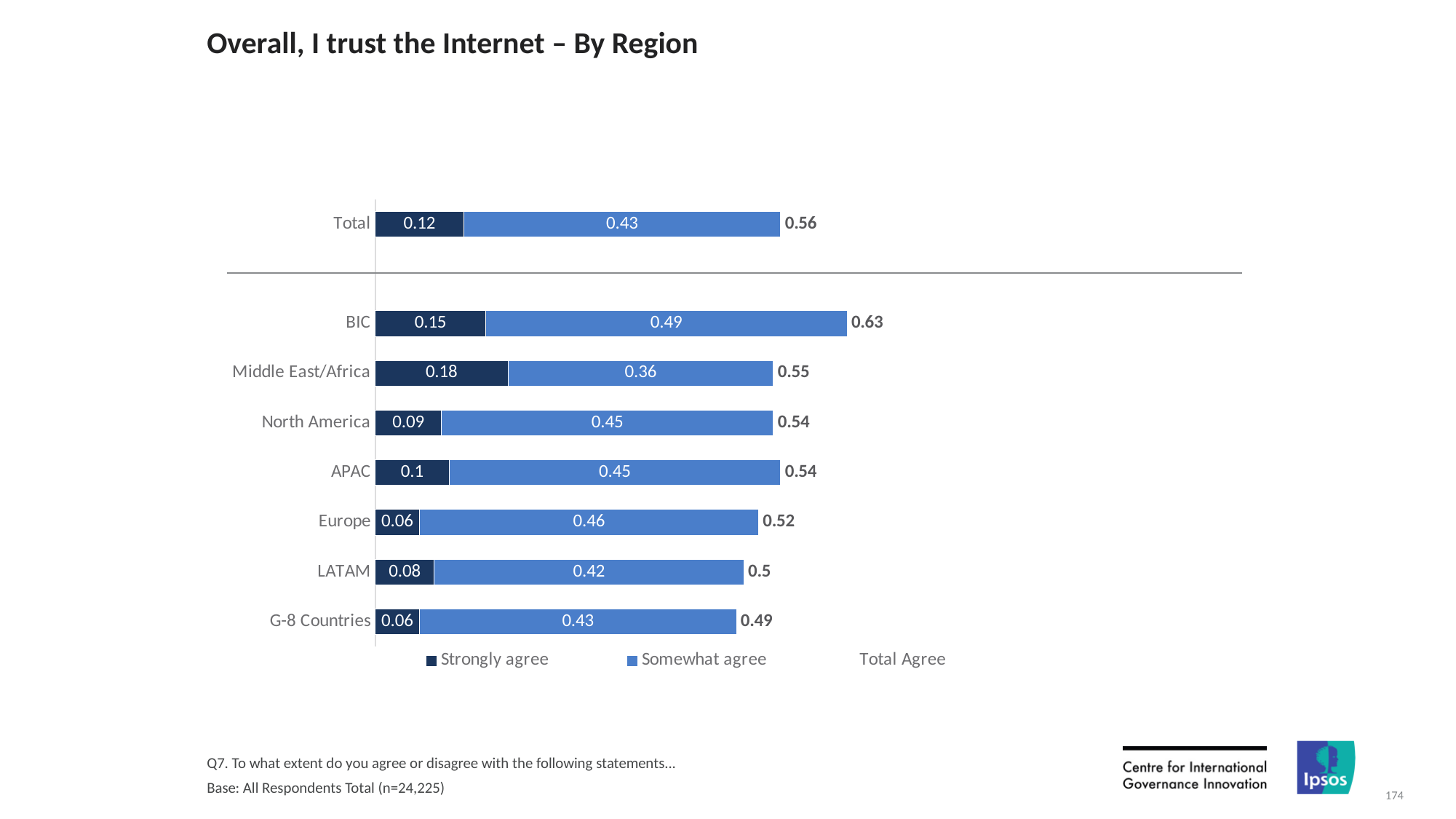
Which region has the highest Total Agree value? BIC What is the title of the chart? Overall, I trust the Internet – By Region What is the Total Agree value for Europe? 0.52 Which is larger, the Somewhat agree value for Europe or for Middle East/Africa? Europe How many entries does the legend list? 3 What kind of chart is shown on the slide? Stacked bar chart Which region has the lowest Total Agree value? G-8 Countries How many regions are shown below the Total bar? 7 Which region has the highest Strongly agree value? Middle East/Africa What is the difference between the Total Agree values for BIC and LATAM? 0.13 What is the Strongly agree value for Middle East/Africa? 0.18 What is the Somewhat agree value for BIC? 0.49